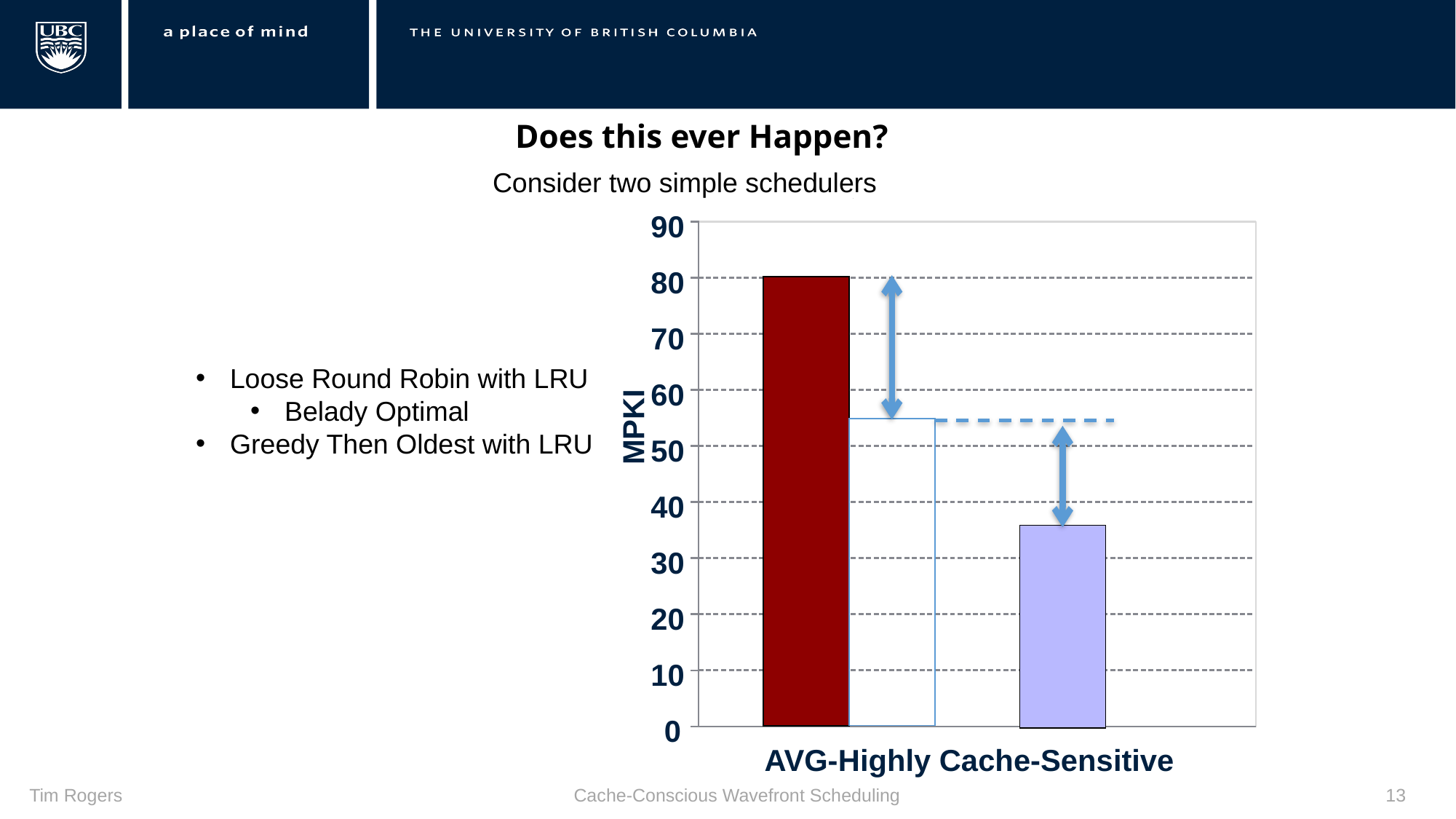
Which bar is the tallest in the chart: the dark red bar, the white bar, or the light blue bar? the dark red bar How many categories are shown on the x axis of the chart? 1 What is the highest value shown on the y axis of the chart? 90 Is the value of the light blue bar greater or less than 40? less What kind of chart is shown on the slide? bar chart How many bars are plotted in the chart? 3 Which is larger, the value of the white (middle) bar or the value of the light blue bar? the white (middle) bar Is the value of the dark red bar greater or less than 70? greater What is the label on the y axis of the chart? MPKI What is the category label on the x axis of the chart? AVG-Highly Cache-Sensitive Is the value of the white (middle) bar greater or less than 50? greater Which bar is the shortest in the chart: the dark red bar, the white bar, or the light blue bar? the light blue bar